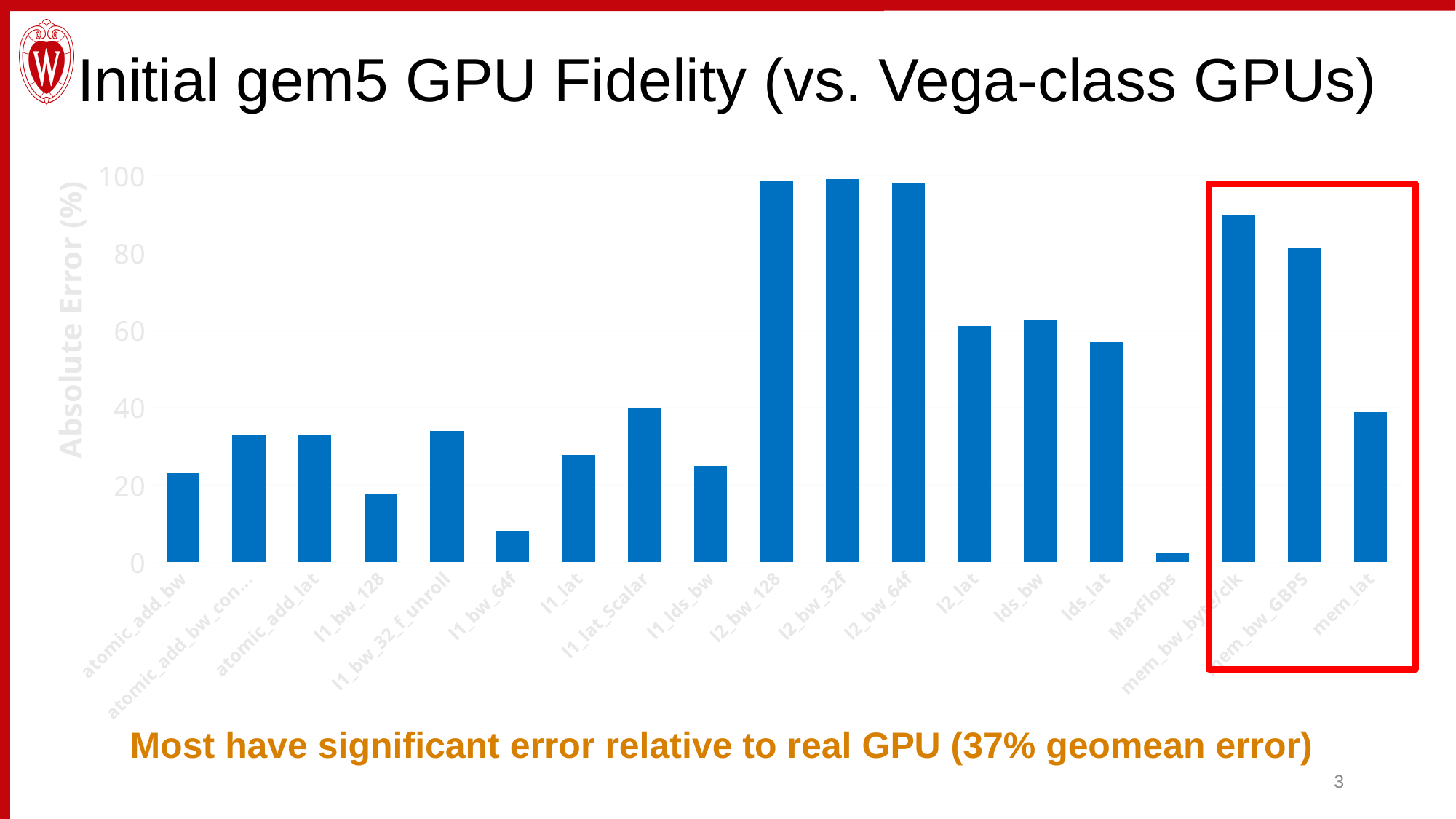
Which has a larger absolute error, mem_bw_byte/clk or mem_lat? mem_bw_byte/clk What is the label of the vertical axis of the chart? Absolute Error (%) Is the value for l2_bw_128 greater or less than 80? greater Which has a larger absolute error, l1_lat_Scalar or l1_bw_128? l1_lat_Scalar Is the value for mem_bw_byte/clk greater or less than 80? greater Which three categories are enclosed by the red box on the chart? mem_bw_byte/clk, mem_bw_GBPS, mem_lat Is the value for l2_lat greater or less than 40? greater How many bars (categories) are plotted in the chart? 19 What kind of chart is shown on the slide? bar chart Which category has the lowest absolute error in the chart? MaxFlops